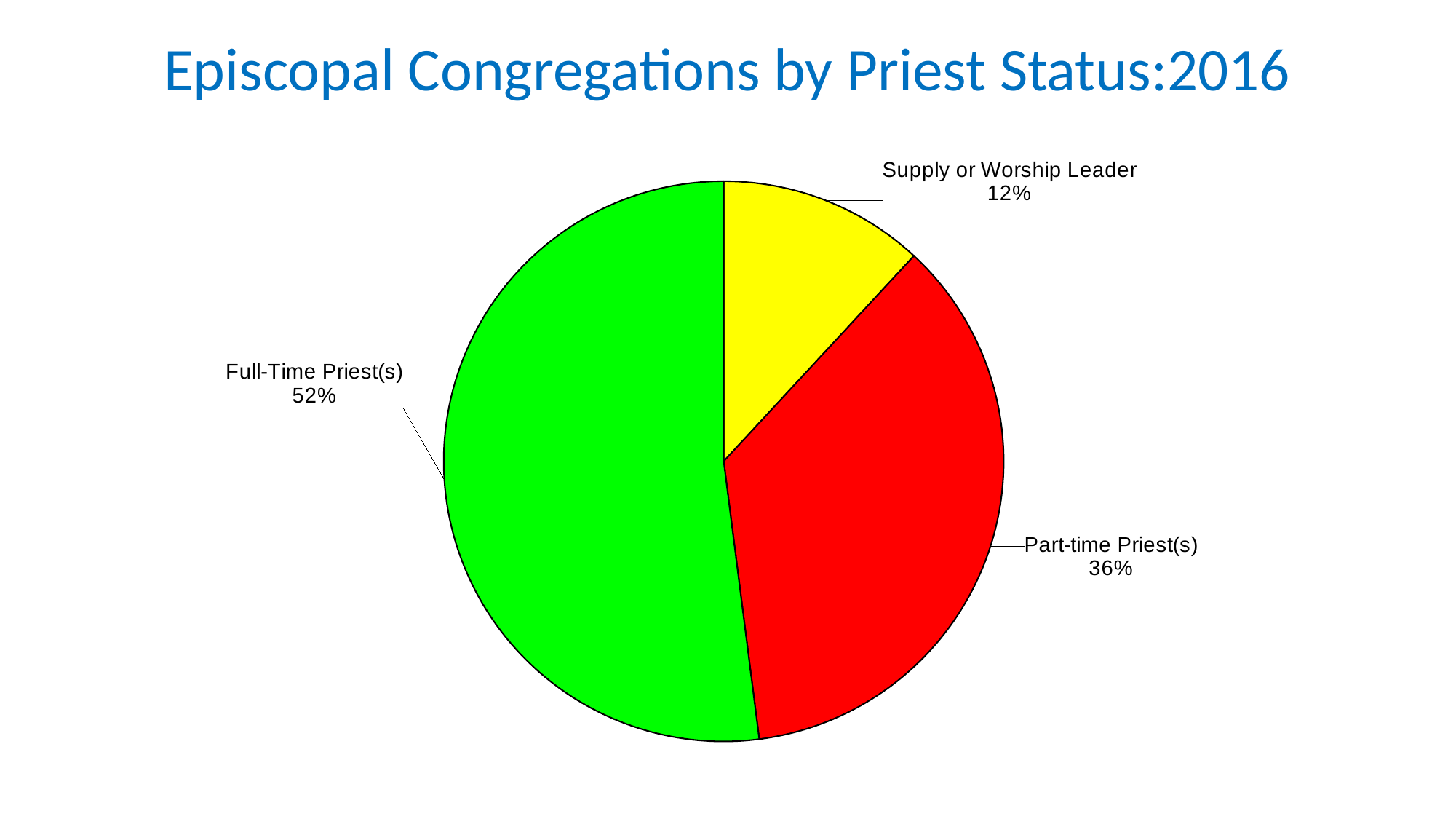
Which priest status category has the smallest share? Supply or Worship Leader What is the difference in percentage points between Part-time Priest(s) and Supply or Worship Leader? 24 What kind of chart is shown on the slide? Pie chart What colour is the Part-time Priest(s) slice? Red What share of congregations have Part-time Priest(s)? 36% What share of congregations have a Supply or Worship Leader? 12% What is the difference in percentage points between Full-Time Priest(s) and Part-time Priest(s)? 16 Which priest status category has the largest share? Full-Time Priest(s) Which is larger, the share for Part-time Priest(s) or for Supply or Worship Leader? Part-time Priest(s) What is the title of the chart? Episcopal Congregations by Priest Status:2016 How many categories does the pie chart show? 3 What share of congregations have Full-Time Priest(s)? 52%